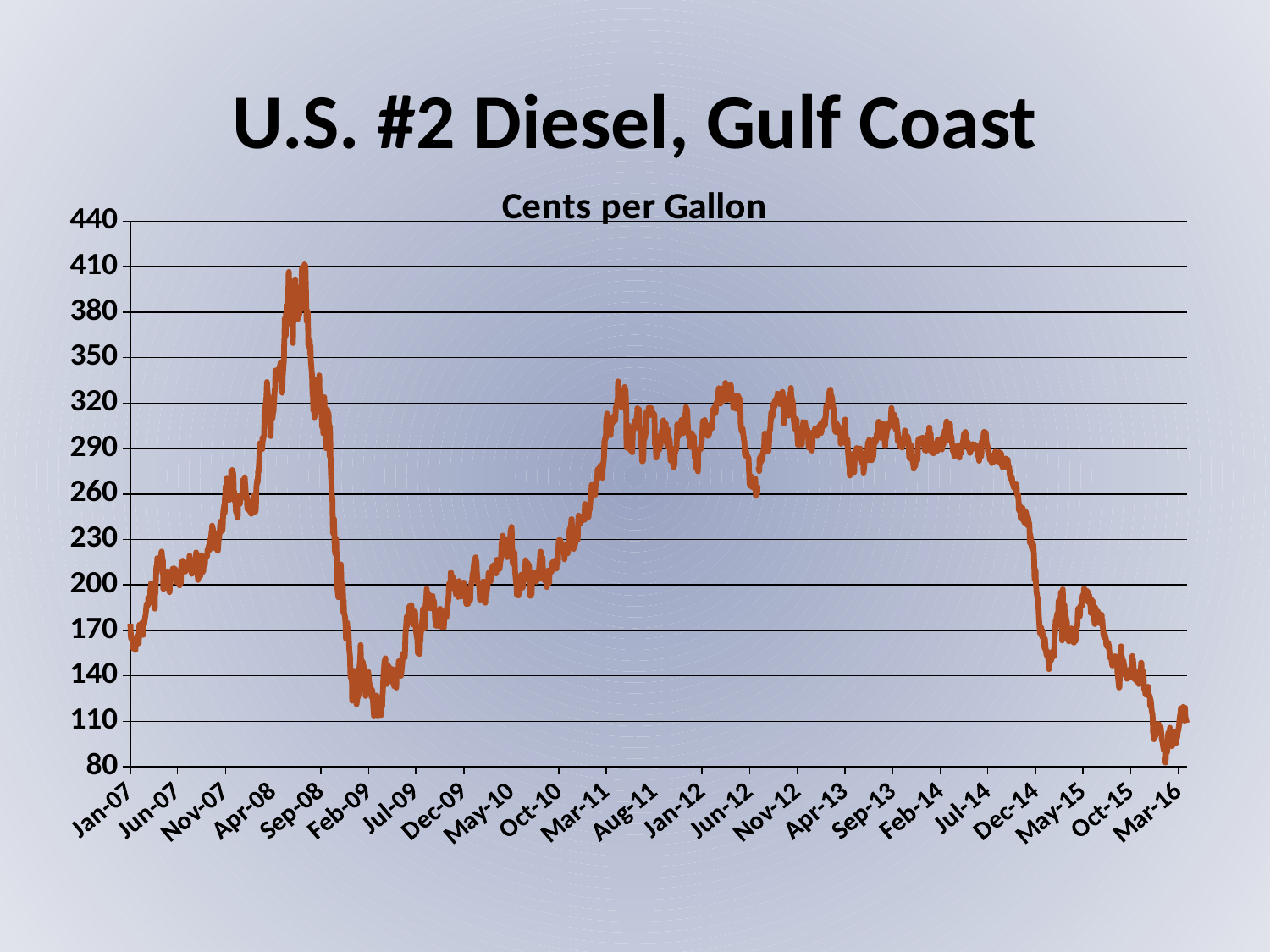
Between Jul-14 and Dec-14, does the line rise or fall? fall Between Feb-09 and Mar-11, does the line rise or fall? rise Is the value at Jan-07 greater or less than 200? less What is the title of the chart? U.S. #2 Diesel, Gulf Coast Is the value around Jan-12 greater or less than 260? greater Is the value around Mar-16 greater or less than 140? less In what units are the values on the chart expressed, according to the subtitle? Cents per Gallon What kind of chart is shown on the slide? line chart Which is higher: the value around Sep-08 or the value around Feb-09? Sep-08